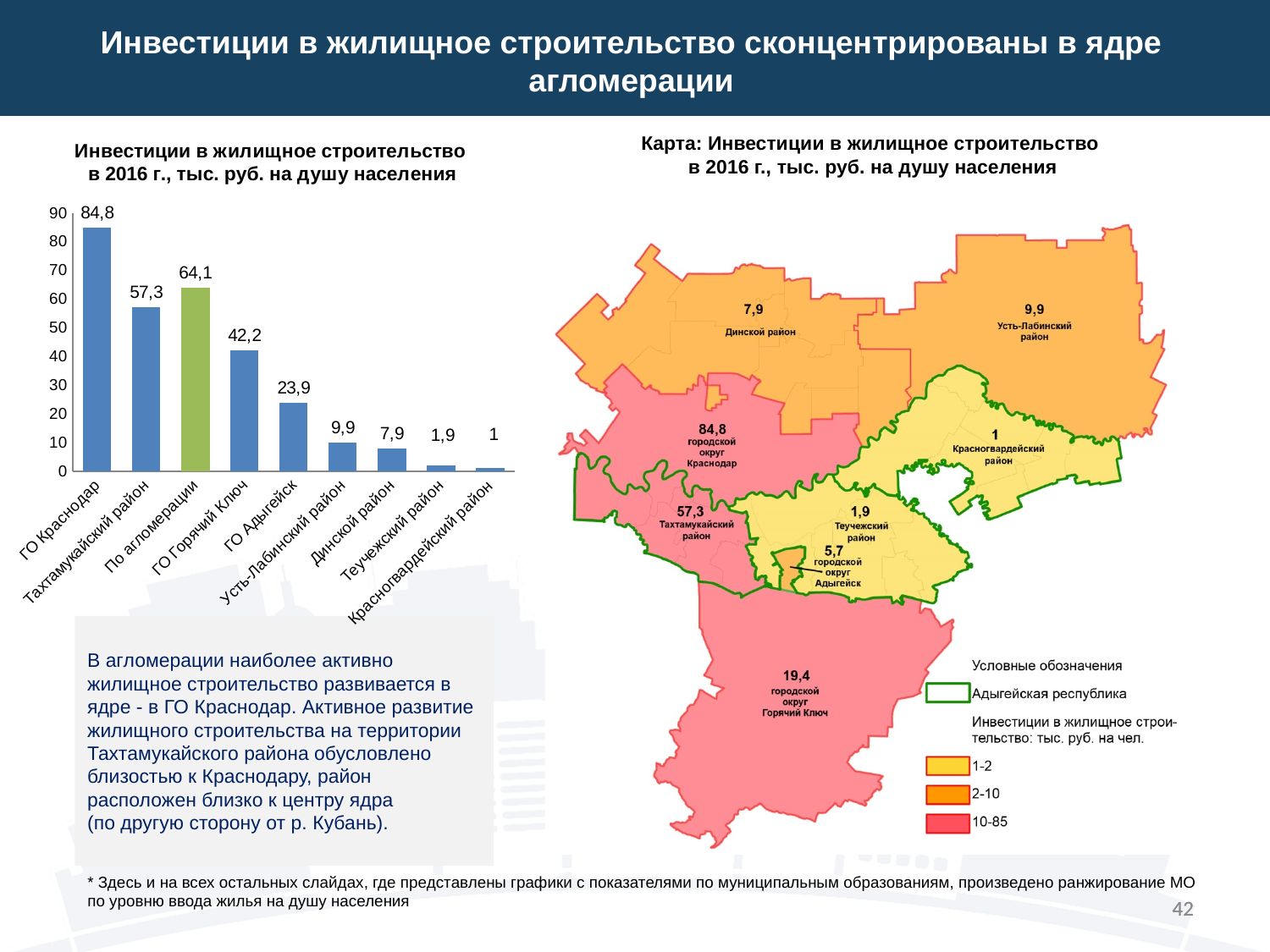
On the bar chart, what is the value for ГО Адыгейск? 23,9 On the bar chart, what is the difference between the values for ГО Краснодар and Тахтамукайский район? 27,5 On the bar chart, which category has the highest value? ГО Краснодар On the bar chart, what is the value for Тахтамукайский район? 57,3 On the bar chart, which is larger: the value for Усть-Лабинский район or Динской район? Усть-Лабинский район On the bar chart, which bar is coloured green rather than blue? По агломерации On the bar chart, what is the value for ГО Горячий Ключ? 42,2 How many categories are shown on the bar chart? 9 On the bar chart, what is the value for ГО Краснодар? 84,8 What type of chart is shown on the left of the slide? Bar chart On the bar chart, what is the value for По агломерации? 64,1 On the bar chart, which category has the lowest value? Красногвардейский район